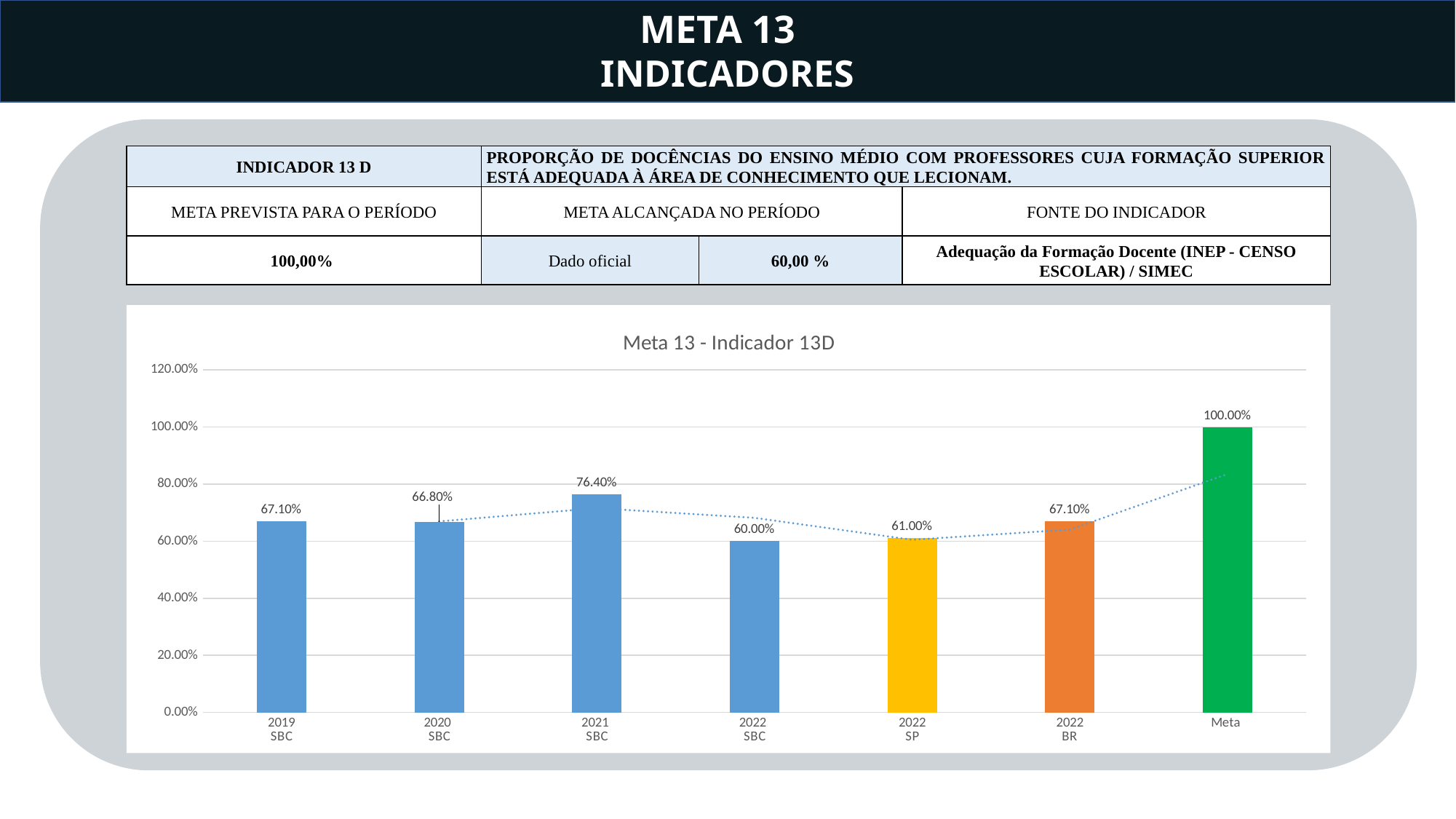
What is the value for 2022 BR? 67.10% Which category has the highest value? Meta What is the title of the chart? Meta 13 - Indicador 13D Which is larger, the value for 2022 SP or the value for 2022 BR? 2022 BR Which category has the lowest value? 2022 SBC How many bars are shown in the chart? 7 What is the value for 2022 SP? 61.00% What kind of chart is this? Bar chart What is the difference between the 2021 SBC value and the 2020 SBC value? 9.60% What is the value for 2021 SBC? 76.40% What is the value for 2020 SBC? 66.80% What is the difference between the Meta value and the 2022 SBC value? 40.00%